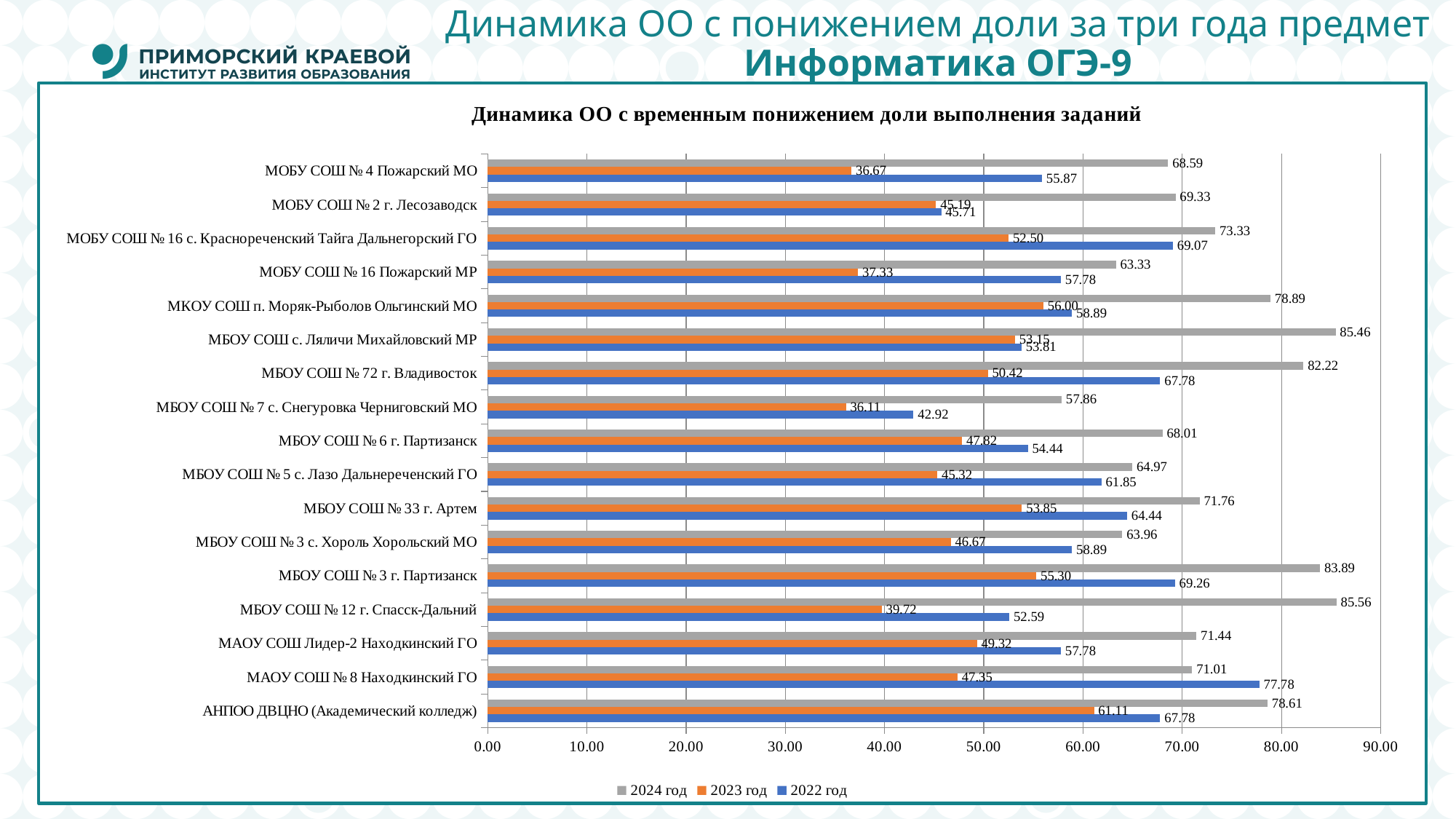
What is the difference between the 2024 год and 2023 год values for МОБУ СОШ № 4 Пожарский МО? 31.92 Which school has the highest 2023 год value? АНПОО ДВЦНО (Академический колледж) What is the 2024 год value for МОБУ СОШ № 4 Пожарский МО? 68.59 What is the 2022 год value for МБОУ СОШ № 72 г. Владивосток? 67.78 What type of chart is shown on the slide? Bar chart How many schools (categories) are shown in the chart? 17 What is the 2023 год value for МБОУ СОШ № 12 г. Спасск-Дальний? 39.72 Which school has the highest 2022 год value? МАОУ СОШ № 8 Находкинский ГО For МАОУ СОШ № 8 Находкинский ГО, which is larger: the 2022 год value or the 2024 год value? 2022 год Which school has the lowest 2022 год value? МБОУ СОШ № 7 с. Снегуровка Черниговский МО How many series does the legend list? 3 What is the title of the chart? Динамика ОО с временным понижением доли выполнения заданий